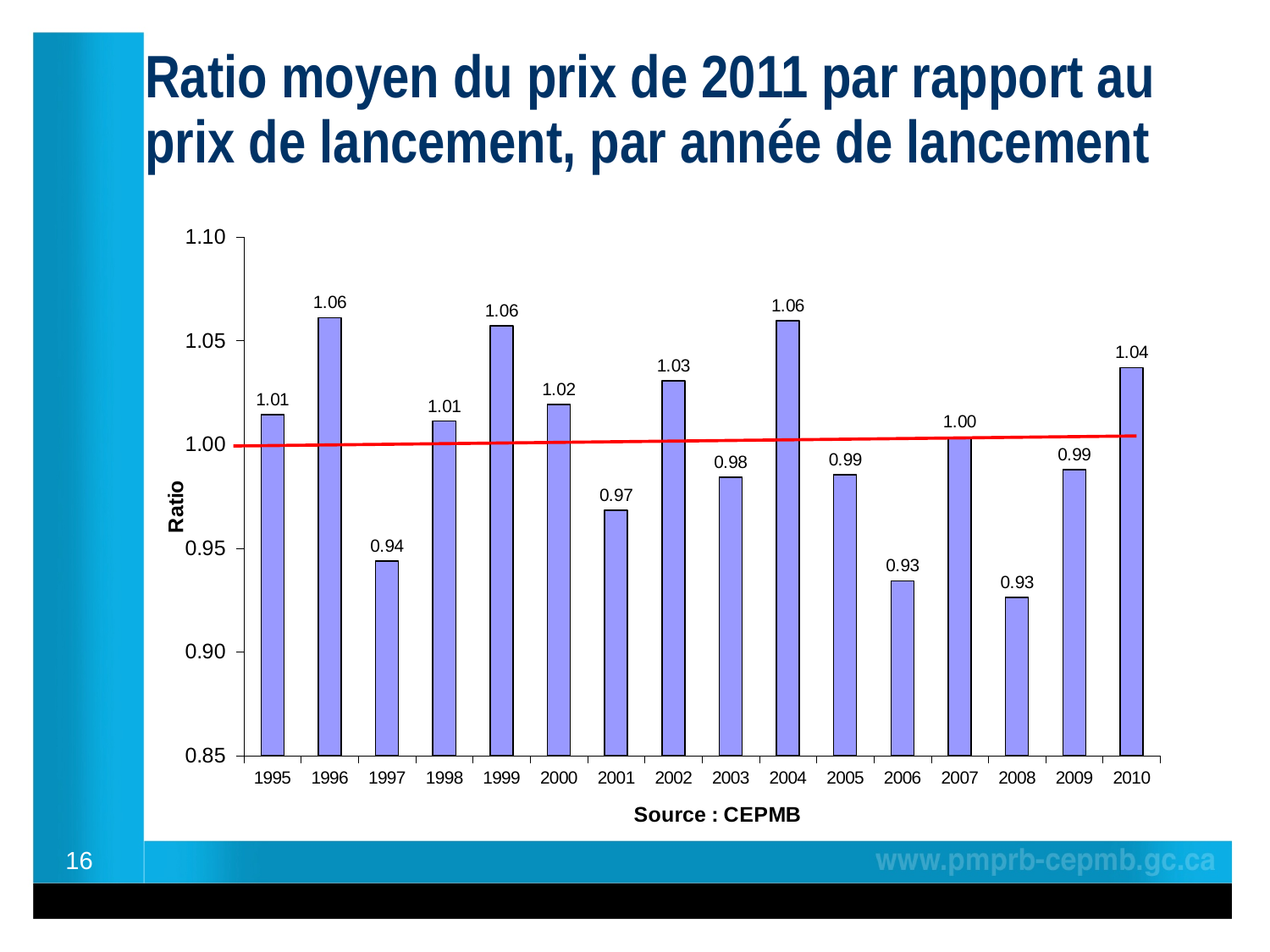
What is the ratio value for 2010? 1.04 What is the label of the y axis? Ratio What is the ratio value for 2004? 1.06 What is the highest ratio value shown on the chart? 1.06 How many launch years are shown on the x axis? 16 Which year has the larger ratio, 1996 or 1997? 1996 What is the difference between the ratio for 2010 and the ratio for 2008? 0.11 What is the ratio value for 2007? 1.00 Is the ratio for 2001 greater or less than 1.00? less What is the ratio value for 1997? 0.94 What is the lowest ratio value shown on the chart? 0.93 What kind of chart is shown on the slide? bar chart